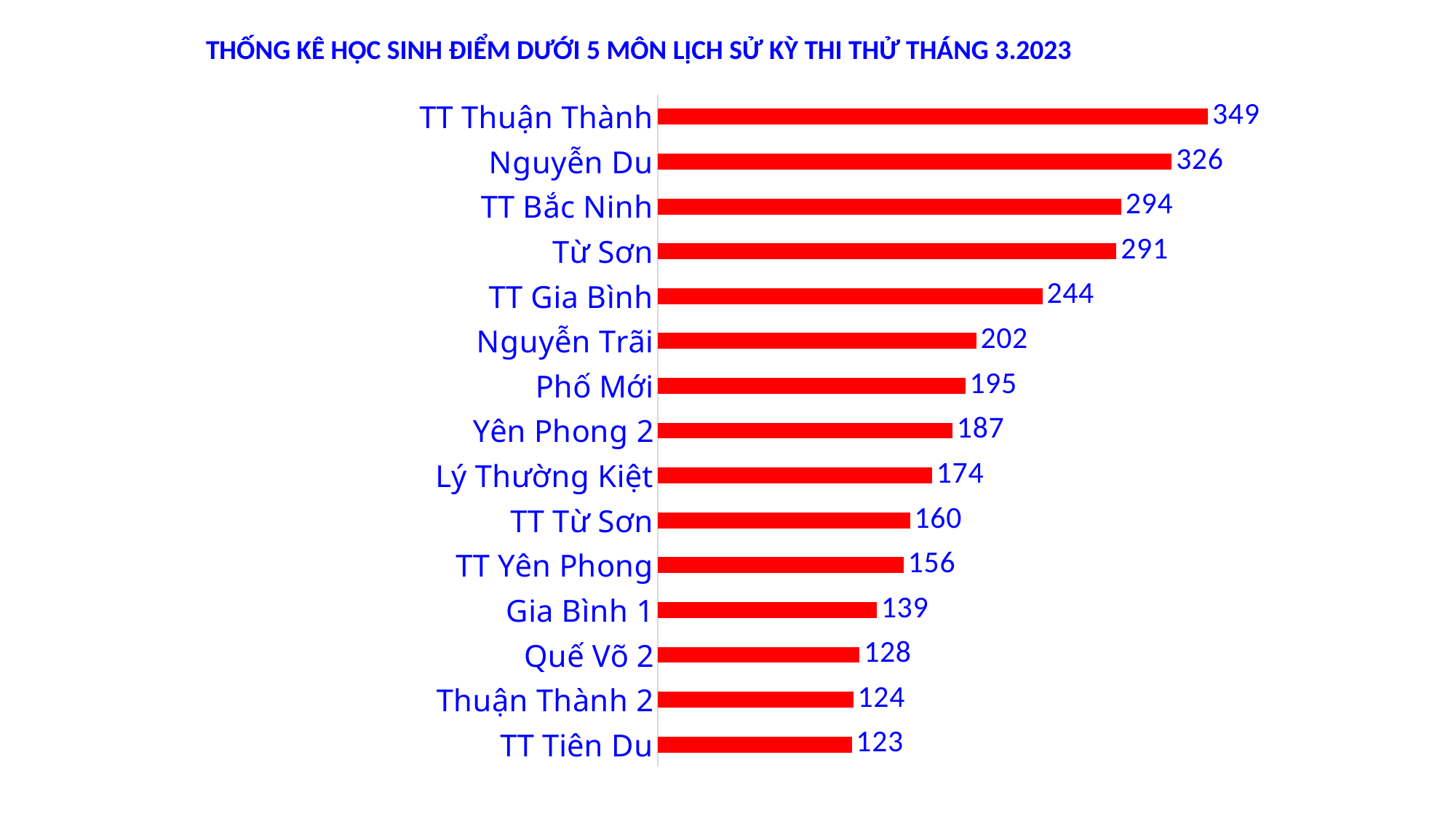
What kind of chart is shown on the slide? bar chart Which category has the lowest value? TT Tiên Du What is the difference between the values for TT Gia Bình and Gia Bình 1? 105 What is the value for Nguyễn Trãi? 202 How many categories are shown in the chart? 15 What is the value for Quế Võ 2? 128 What is the value for TT Thuận Thành? 349 Which category has the highest value? TT Thuận Thành Which is larger, the value for Phố Mới or the value for Yên Phong 2? Phố Mới What is the title of the chart? THỐNG KÊ HỌC SINH ĐIỂM DƯỚI 5 MÔN LỊCH SỬ KỲ THI THỬ THÁNG 3.2023 What is the difference between the values for TT Thuận Thành and Nguyễn Du? 23 What colour are the bars in the chart? red